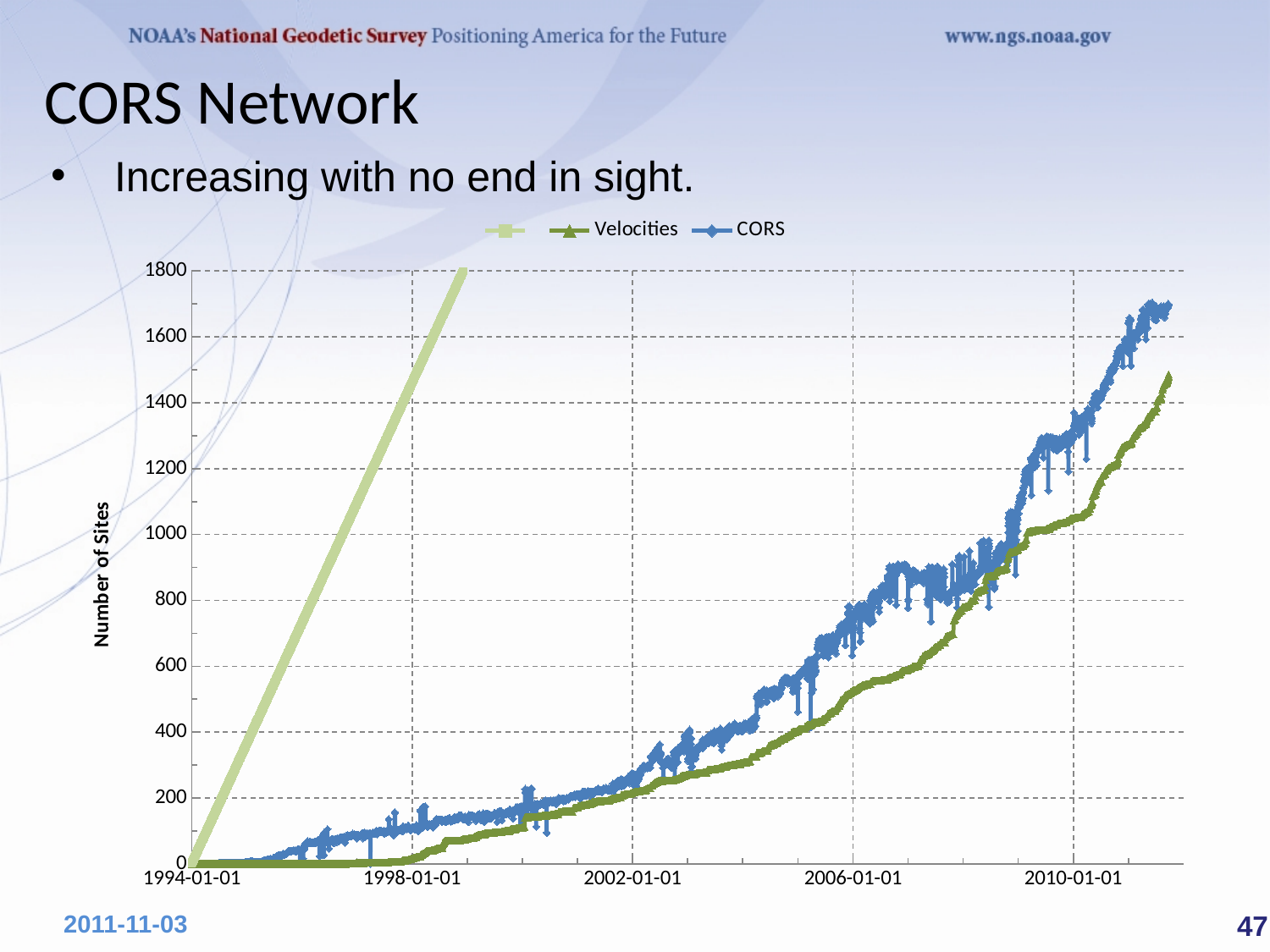
At 2010-01-01, which series has the higher value, CORS or Velocities? CORS Does the CORS series rise or fall from 1994-01-01 to the end of the chart? rise At 1998-01-01, which series has the higher value, CORS or Velocities? CORS Is the CORS value at 2002-01-01 greater or less than 400? less Which series is plotted in blue? CORS What is the title of the vertical axis? Number of Sites Is the Velocities value at 2010-01-01 greater or less than 800? greater How many series does the chart legend list? 3 Does the Velocities series rise or fall over time along the x axis? rise Is the CORS value at the right end of the chart greater or less than 1600? greater What kind of chart is shown on the slide? line chart